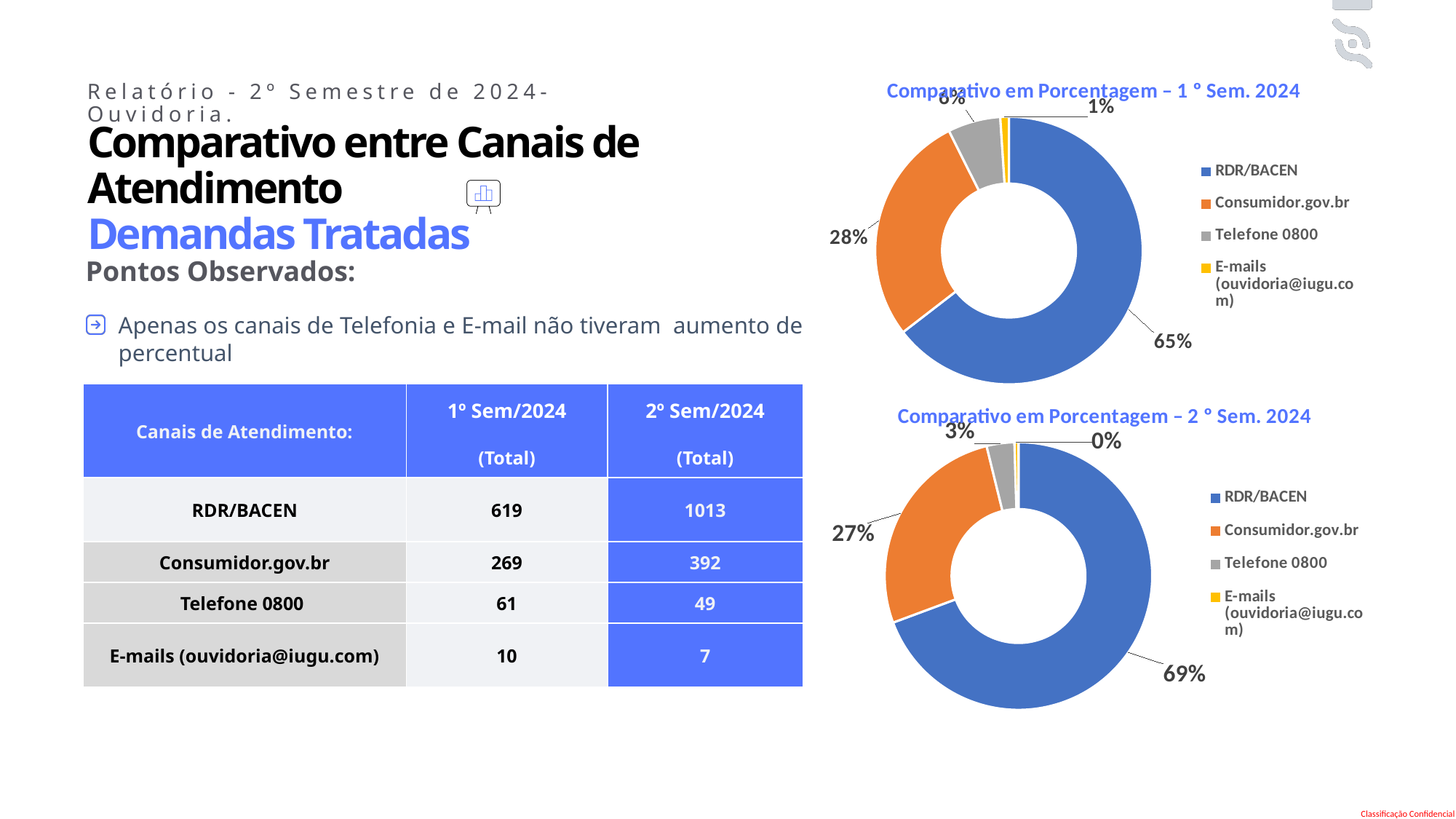
In the chart titled 'Comparativo em Porcentagem – 2 ° Sem. 2024', which category has the smallest share? E-mails (ouvidoria@iugu.com) In the chart titled 'Comparativo em Porcentagem – 2 ° Sem. 2024', what is the share for Consumidor.gov.br? 27% In the chart titled 'Comparativo em Porcentagem – 1 ° Sem. 2024', what is the share for RDR/BACEN? 65% In the chart titled 'Comparativo em Porcentagem – 2 ° Sem. 2024', what is the share for E-mails (ouvidoria@iugu.com)? 0% In the chart titled 'Comparativo em Porcentagem – 1 ° Sem. 2024', which category has the largest share? RDR/BACEN How many categories does the legend of the chart titled 'Comparativo em Porcentagem – 1 ° Sem. 2024' list? 4 In the chart titled 'Comparativo em Porcentagem – 1 ° Sem. 2024', what is the share for Consumidor.gov.br? 28% In the chart titled 'Comparativo em Porcentagem – 2 ° Sem. 2024', what is the share for RDR/BACEN? 69% In the chart titled 'Comparativo em Porcentagem – 2 ° Sem. 2024', which is larger, the share for Consumidor.gov.br or the share for Telefone 0800? Consumidor.gov.br What kind of chart is the chart titled 'Comparativo em Porcentagem – 2 ° Sem. 2024'? Doughnut (pie) chart In the chart titled 'Comparativo em Porcentagem – 1 ° Sem. 2024', what is the share for Telefone 0800? 6% In the chart titled 'Comparativo em Porcentagem – 1 ° Sem. 2024', what is the difference in percentage points between RDR/BACEN and Consumidor.gov.br? 37